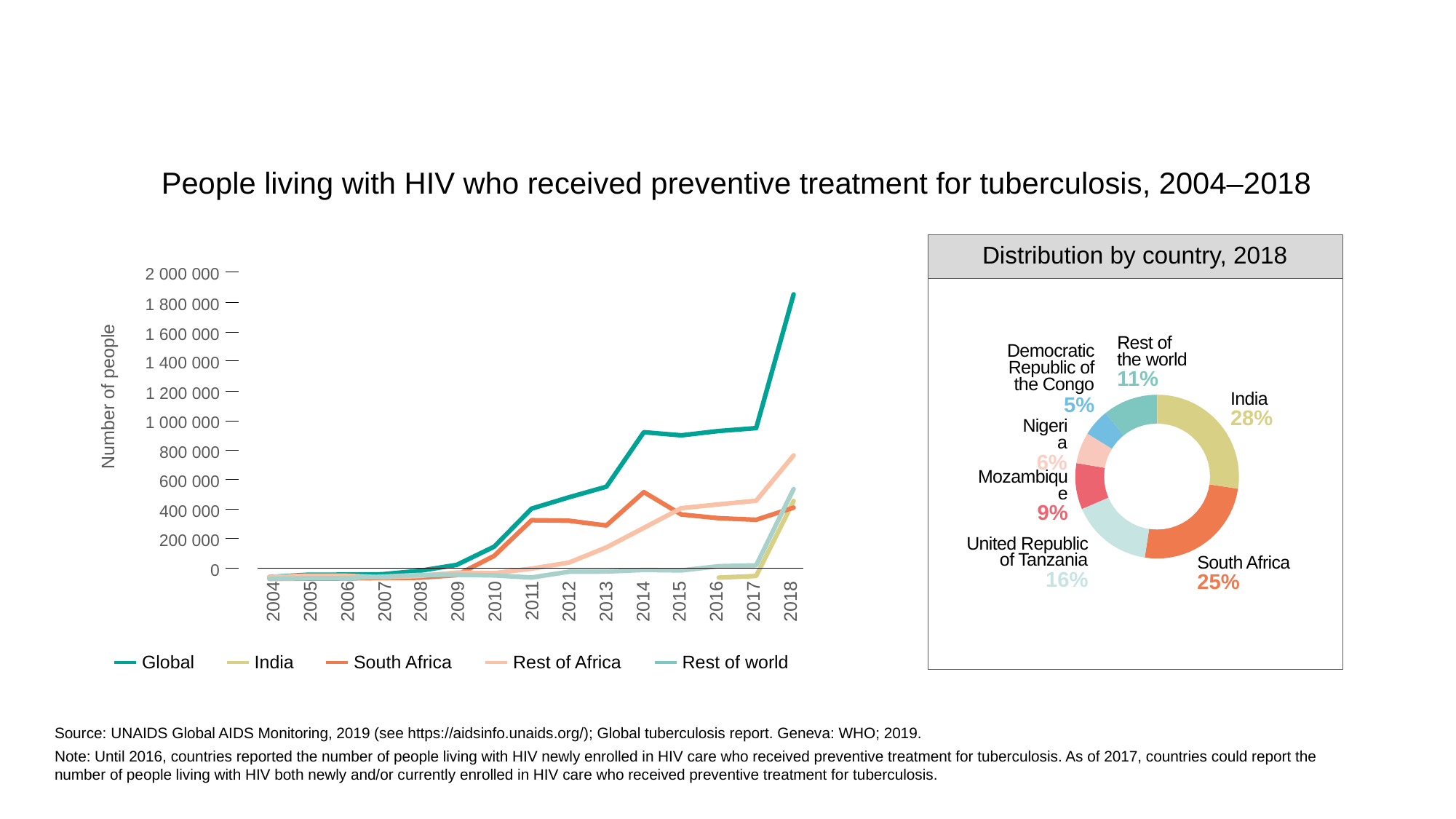
In the 'Distribution by country, 2018' donut chart, which country has the largest share? India How many slices does the 'Distribution by country, 2018' donut chart have? 7 What kind of chart is the left-hand chart showing the number of people from 2004 to 2018? Line chart In the 'Distribution by country, 2018' donut chart, what share does South Africa have? 25% In the left-hand line chart, does the Global series generally rise or fall from 2004 to 2018? Rise In the 'Distribution by country, 2018' donut chart, which has the larger share, United Republic of Tanzania or Mozambique? United Republic of Tanzania In the 'Distribution by country, 2018' donut chart, which category has the smallest share? Democratic Republic of the Congo In the 'Distribution by country, 2018' donut chart, how many percentage points larger is India's share than South Africa's? 3 percentage points In the left-hand line chart, is the Global value for 2018 greater or less than 1 600 000? greater In the 'Distribution by country, 2018' donut chart, what share does India have? 28% How many series does the legend of the left-hand line chart list? 5 In the left-hand line chart, is the Rest of Africa value for 2018 greater or less than 600 000? greater